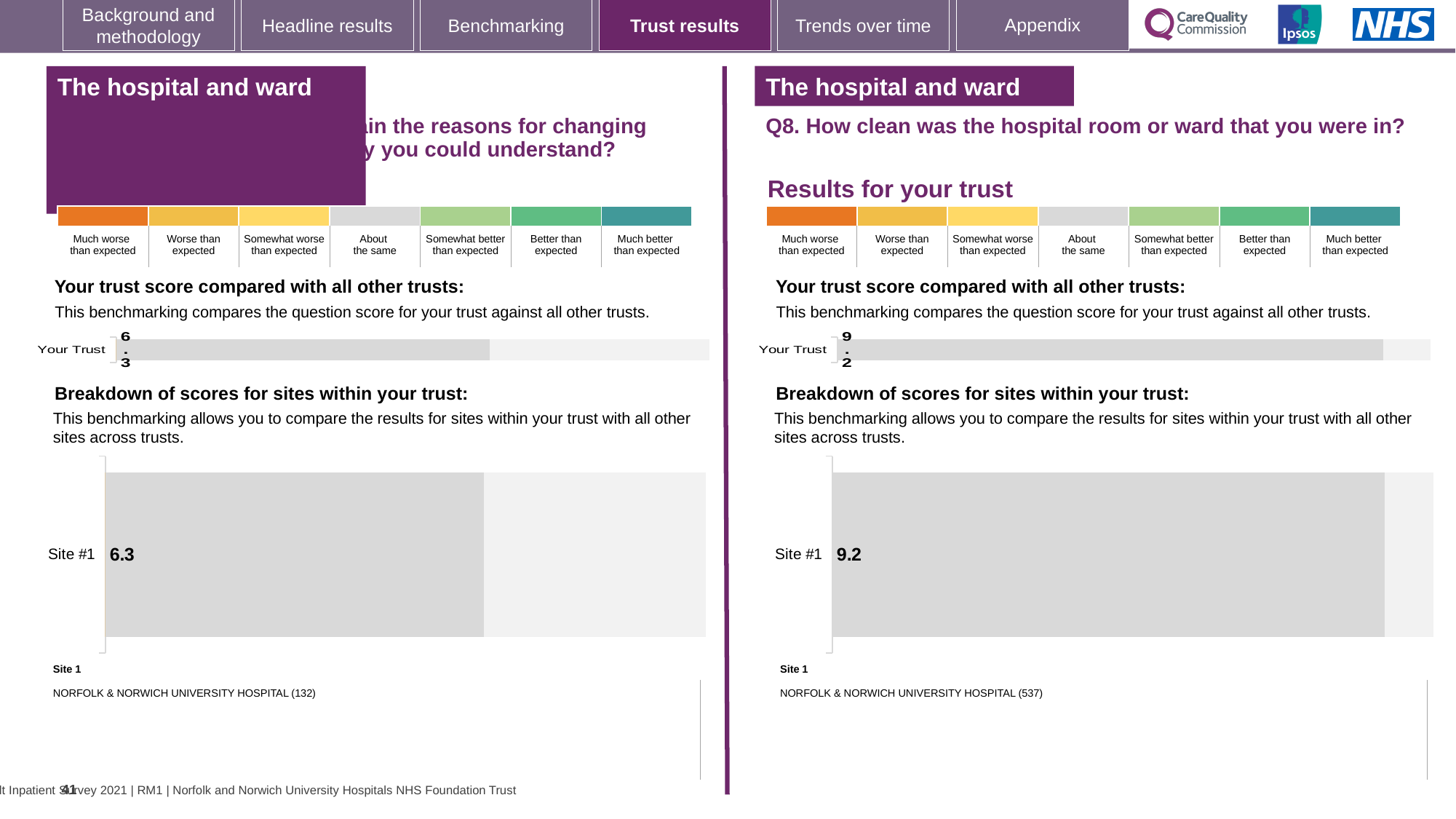
What is the difference between the Site #1 score in the right-hand (Q8) breakdown chart and the Site #1 score in the left-hand breakdown chart? 2.9 On the right half of the slide (Q8, how clean was the hospital room or ward), what is the value shown for Your Trust in the 'Your trust score compared with all other trusts' chart? 9.2 On the left half of the slide, what is the name of the site labelled Site 1 below the breakdown chart? NORFOLK & NORWICH UNIVERSITY HOSPITAL (132) How many sites are shown in the 'Breakdown of scores for sites within your trust' chart on the left half of the slide? 1 On the right half of the slide (Q8), what is the name of the site labelled Site 1 below the breakdown chart? NORFOLK & NORWICH UNIVERSITY HOSPITAL (537) What type of chart is used to show the Site #1 score in the breakdown section on the right half of the slide (Q8)? Bar chart Which is larger: the Your Trust score in the left-hand chart or the Your Trust score in the right-hand (Q8) chart? The right-hand (Q8) chart What type of chart is used to show the Your Trust score on the left half of the slide? Bar chart How many sites are shown in the 'Breakdown of scores for sites within your trust' chart on the right half of the slide (Q8)? 1 On the left half of the slide, what is the value shown for Your Trust in the 'Your trust score compared with all other trusts' chart? 6.3 On the left half of the slide, what score is shown for Site #1 in the 'Breakdown of scores for sites within your trust' chart? 6.3 On the right half of the slide (Q8), what score is shown for Site #1 in the 'Breakdown of scores for sites within your trust' chart? 9.2